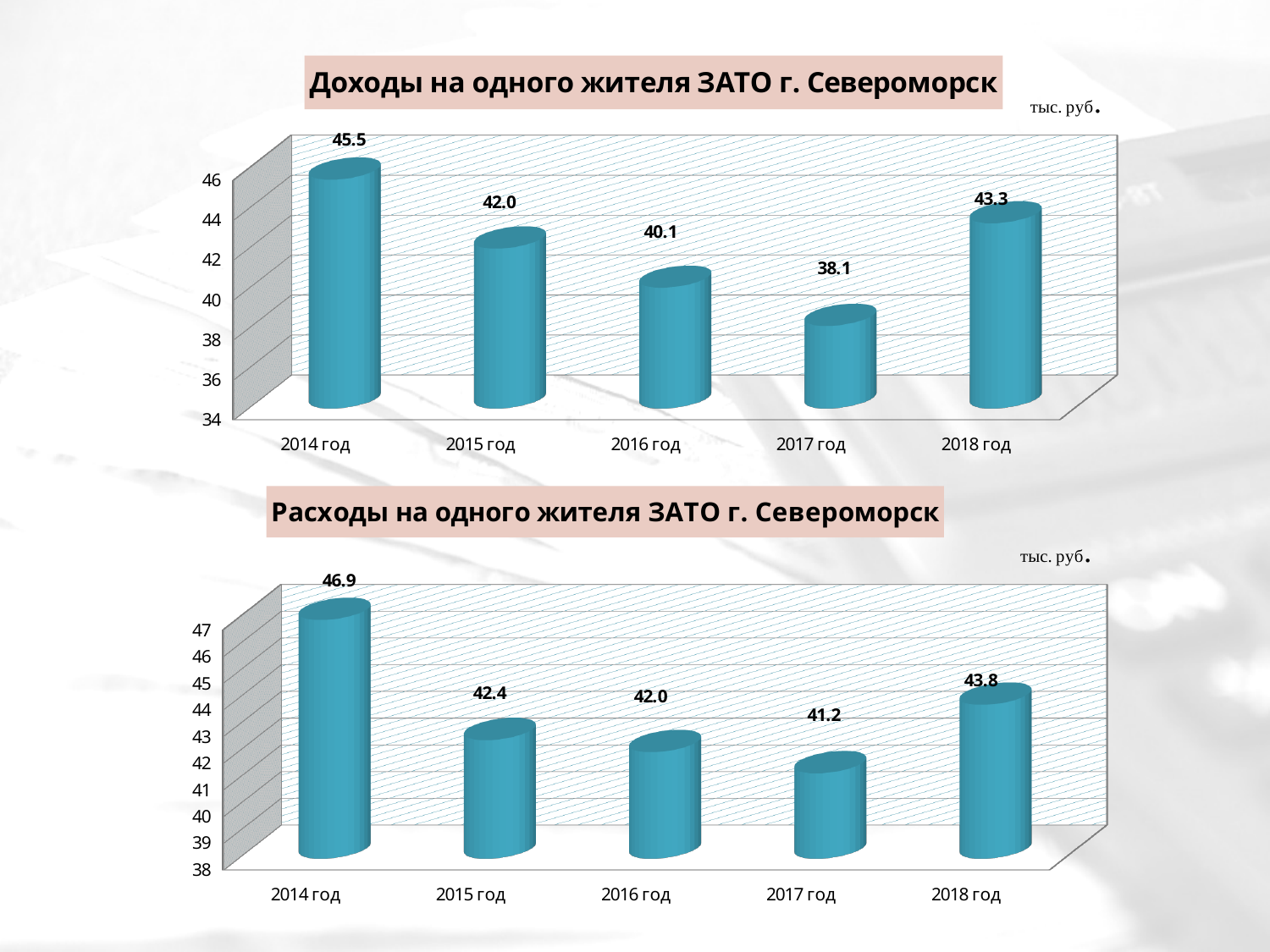
In the chart 'Доходы на одного жителя ЗАТО г. Североморск', how many years are shown on the x axis? 5 In the chart 'Доходы на одного жителя ЗАТО г. Североморск', do the values rise or fall from 2014 год to 2017 год? fall In the chart 'Расходы на одного жителя ЗАТО г. Североморск', what is the value for 2018 год? 43.8 In the chart 'Расходы на одного жителя ЗАТО г. Североморск', which year has the highest value? 2014 год In the chart 'Доходы на одного жителя ЗАТО г. Североморск', what is the difference between the values for 2014 год and 2017 год? 7.4 In the chart 'Расходы на одного жителя ЗАТО г. Североморск', which is larger, the value for 2015 год or 2016 год? 2015 год What kind of chart is the bottom chart on the slide? bar chart In the chart 'Расходы на одного жителя ЗАТО г. Североморск', is the value for 2017 год greater or less than 42? less In the chart 'Доходы на одного жителя ЗАТО г. Североморск', which year has the lowest value? 2017 год In the chart 'Расходы на одного жителя ЗАТО г. Североморск', what is the difference between the values for 2018 год and 2017 год? 2.6 In the chart 'Доходы на одного жителя ЗАТО г. Североморск', what is the value for 2014 год? 45.5 What unit is indicated next to the top chart? тыс. руб.